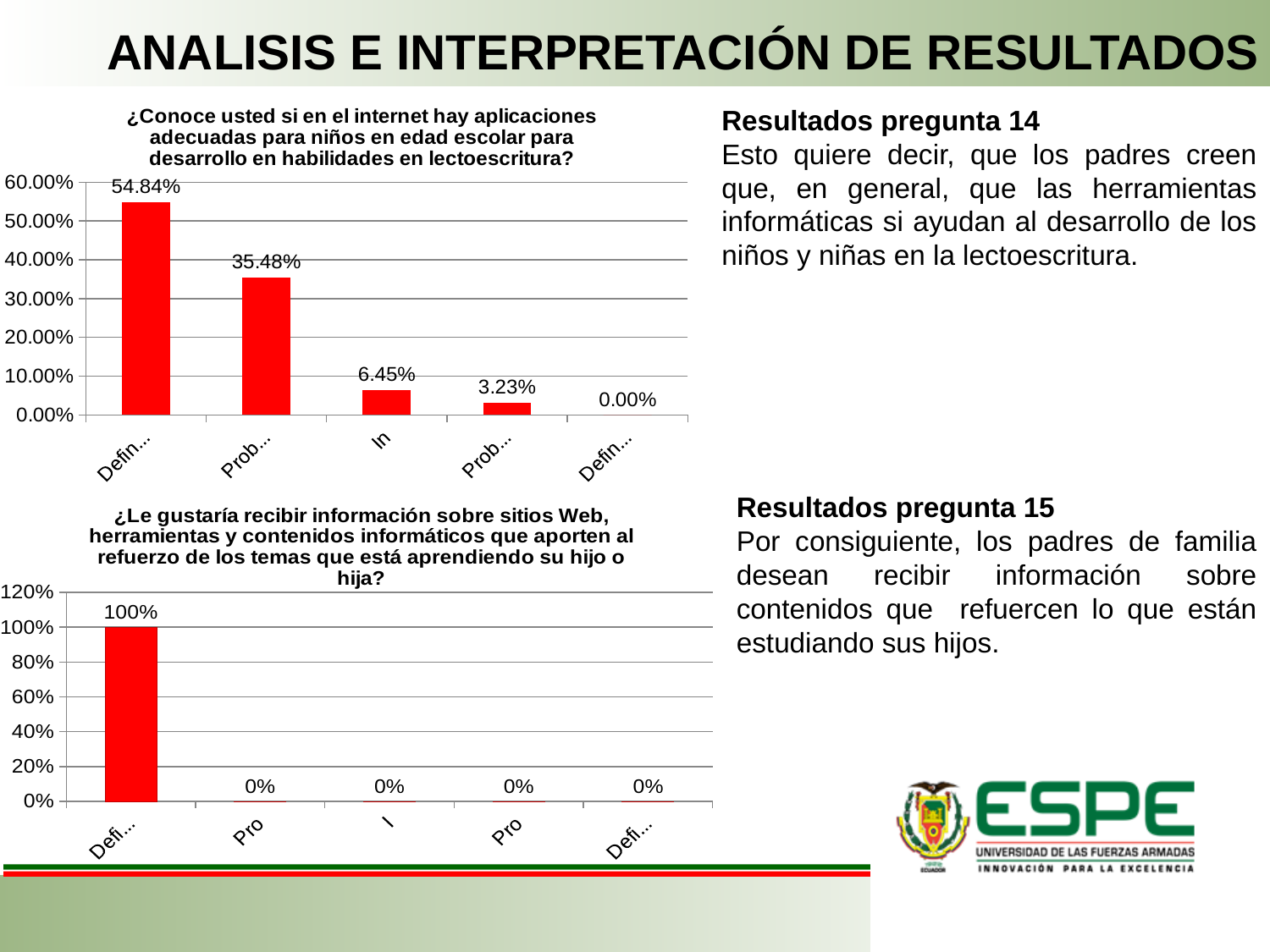
In the bottom chart titled '¿Le gustaría recibir información sobre sitios Web...', what is the value of the first bar from the left? 100% In the top chart, what is the value shown on the first bar from the left? 54.84% How many bars (categories) are plotted in the top chart? 5 In the top chart, which is larger: the third bar from the left or the fourth bar from the left? the third bar (6.45%) What kind of chart is the top chart titled '¿Conoce usted si en el internet hay aplicaciones adecuadas para niños en edad escolar para desarrollo en habilidades en lectoescritura?'? bar chart In the top chart, do the values rise or fall from left to right along the x axis? fall In the top chart, what is the value shown on the second bar from the left? 35.48% In the bottom chart, how many categories show a value of 0%? 4 In the top chart, what is the lowest value shown? 0.00% What colour are the bars in the bottom chart? red In the top chart, what is the difference between the first bar (54.84%) and the second bar (35.48%)? 19.36% In the top chart, what is the highest value shown? 54.84%